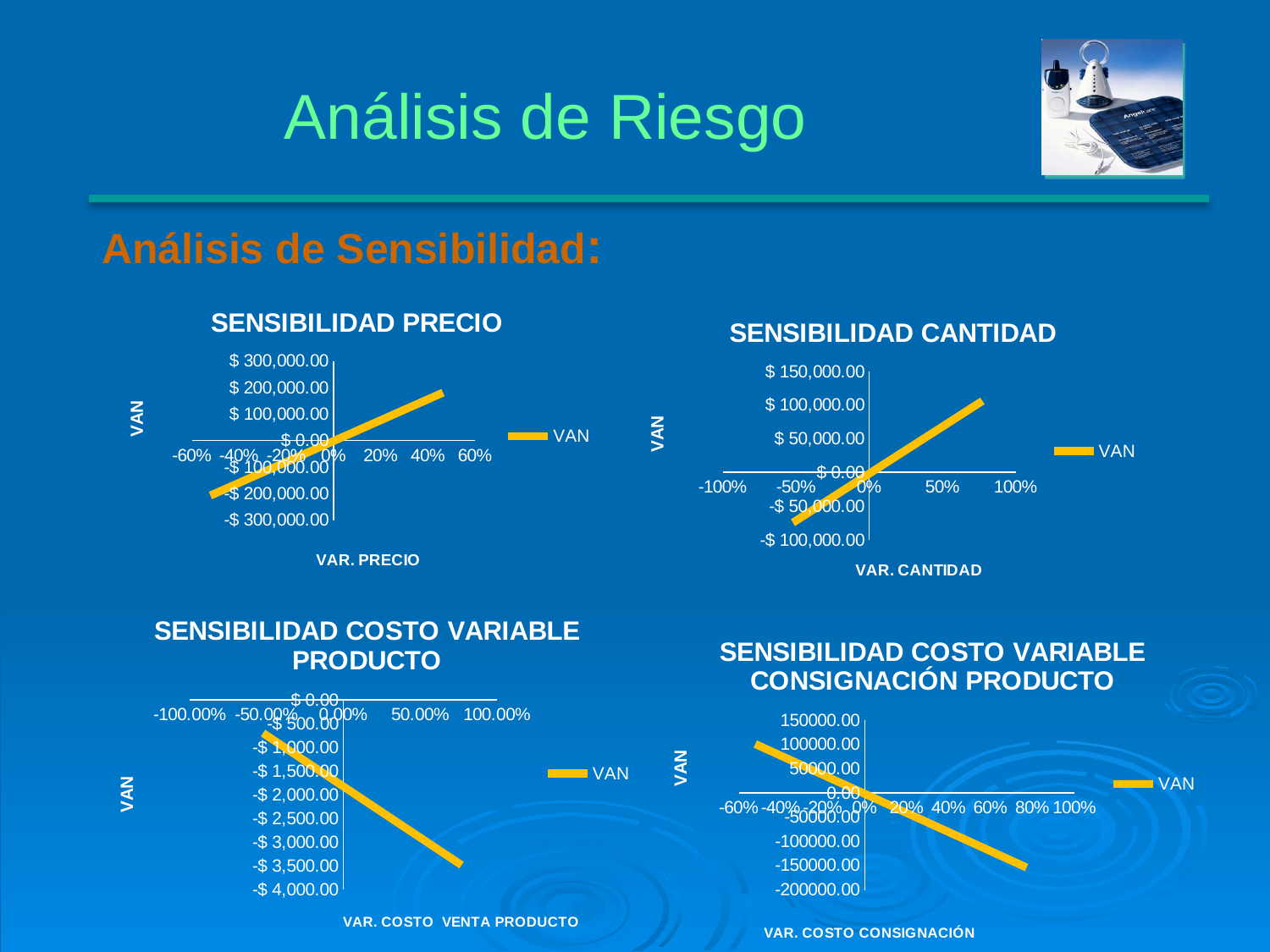
In the SENSIBILIDAD CANTIDAD chart, does VAN rise or fall as VAR. CANTIDAD increases along the x axis? rise In the SENSIBILIDAD COSTO VARIABLE CONSIGNACIÓN PRODUCTO chart, is the VAN value at the left end of the line (around -50%) greater or less than 50000.00? greater In the SENSIBILIDAD COSTO VARIABLE CONSIGNACIÓN PRODUCTO chart, does VAN rise or fall as VAR. COSTO CONSIGNACIÓN increases? fall In the SENSIBILIDAD PRECIO chart, does VAN rise or fall as VAR. PRECIO increases along the x axis? rise What kind of chart is the SENSIBILIDAD PRECIO chart? line chart How many series does the legend of the SENSIBILIDAD CANTIDAD chart list? 1 In the SENSIBILIDAD PRECIO chart, is the VAN value at the left end of the line (around -50%) greater or less than -$100,000.00? less In the SENSIBILIDAD PRECIO chart, is the VAN value at the right end of the line (around 50%) greater or less than $100,000.00? greater What is the x-axis title of the SENSIBILIDAD CANTIDAD chart? VAR. CANTIDAD